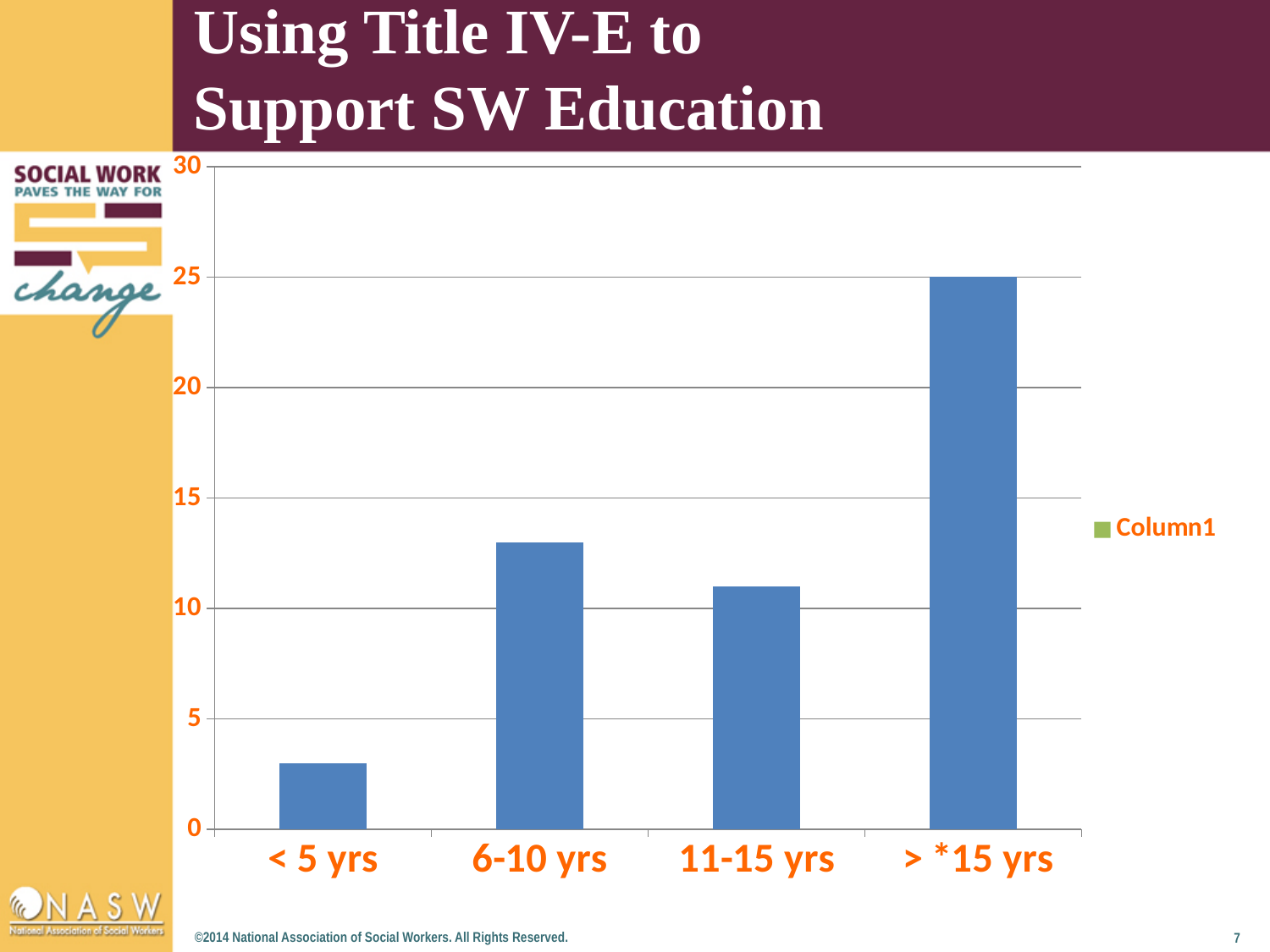
What is the name of the series shown in the chart legend? Column1 Which category has the lowest bar in the chart? < 5 yrs What is the value for > *15 yrs in the chart? 25 How many categories are shown on the x axis of the chart? 4 Is the value for 11-15 yrs greater or less than 15? less Which is larger, the value for 6-10 yrs or the value for 11-15 yrs? 6-10 yrs Is the value for < 5 yrs greater or less than 5? less How many series does the chart legend list? 1 Is the value for 6-10 yrs greater or less than 10? greater Which category has the highest bar in the chart? > *15 yrs What type of chart is shown on the slide? bar chart What is the highest value shown on the chart's vertical axis? 30